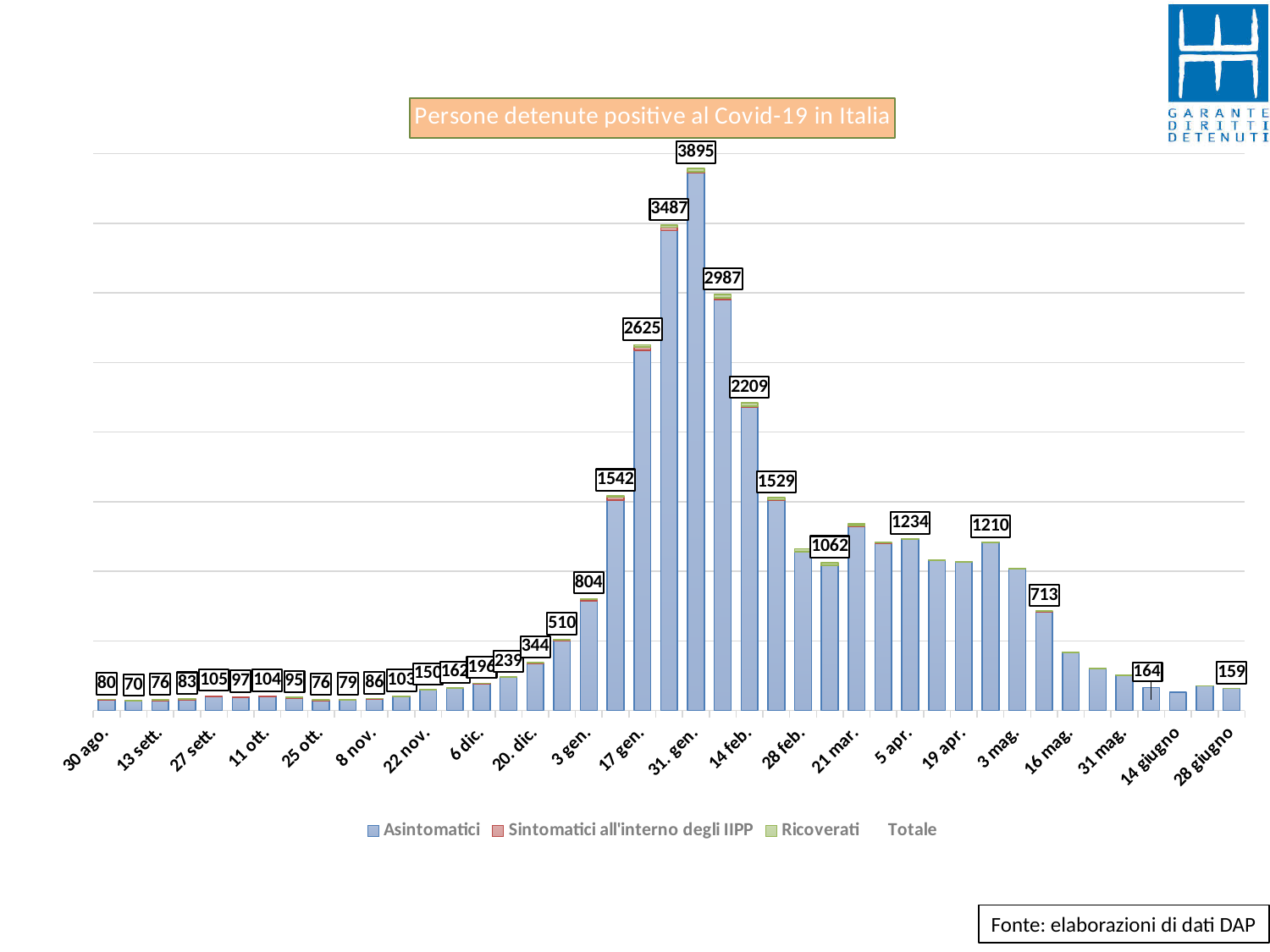
What is the total value labelled for 30 ago.? 80 What is the total value labelled for 3 gen.? 804 What is the difference between the totals for 31 gen. and 14 feb.? 1686 Which date has the highest total of positive detainees? 31 gen. Do the totals rise or fall from 30 ago. to 31 gen.? rise How many series does the legend list? 4 What is the lowest value shown among the data labels? 70 What is the total value labelled for 31 gen.? 3895 What kind of chart is shown on the slide? bar chart What is the total value labelled for 28 giugno? 159 What is the title of the chart? Persone detenute positive al Covid-19 in Italia Which is larger, the total for 17 gen. or the total for 14 feb.? 17 gen.